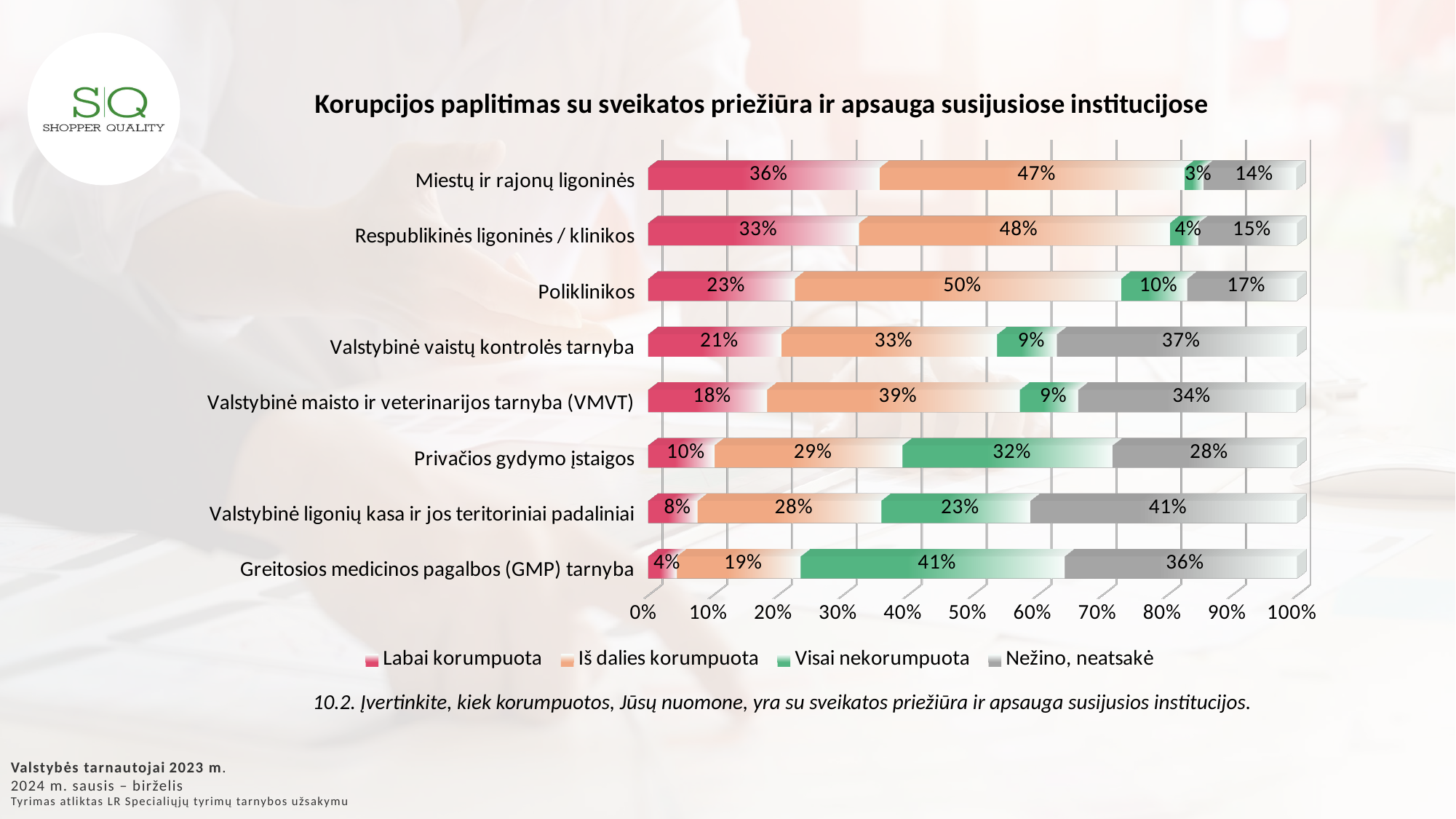
How many categories (institutions) are shown on the chart? 8 What kind of chart is shown on the slide? Stacked bar chart What is the "Iš dalies korumpuota" value for Poliklinikos? 50% How many series does the legend list? 4 What is the "Visai nekorumpuota" value for Greitosios medicinos pagalbos (GMP) tarnyba? 41% What is the title of the chart? Korupcijos paplitimas su sveikatos priežiūra ir apsauga susijusiose institucijose What is the difference between the "Iš dalies korumpuota" values for Respublikinės ligoninės / klinikos and Greitosios medicinos pagalbos (GMP) tarnyba? 29% Which category has the lowest "Visai nekorumpuota" value? Miestų ir rajonų ligoninės What is the "Labai korumpuota" value for Miestų ir rajonų ligoninės? 36% Which is larger: the "Visai nekorumpuota" value for Privačios gydymo įstaigos or for Valstybinė ligonių kasa ir jos teritoriniai padaliniai? Privačios gydymo įstaigos What is the "Nežino, neatsakė" value for Valstybinė ligonių kasa ir jos teritoriniai padaliniai? 41% Which category has the highest "Labai korumpuota" value? Miestų ir rajonų ligoninės